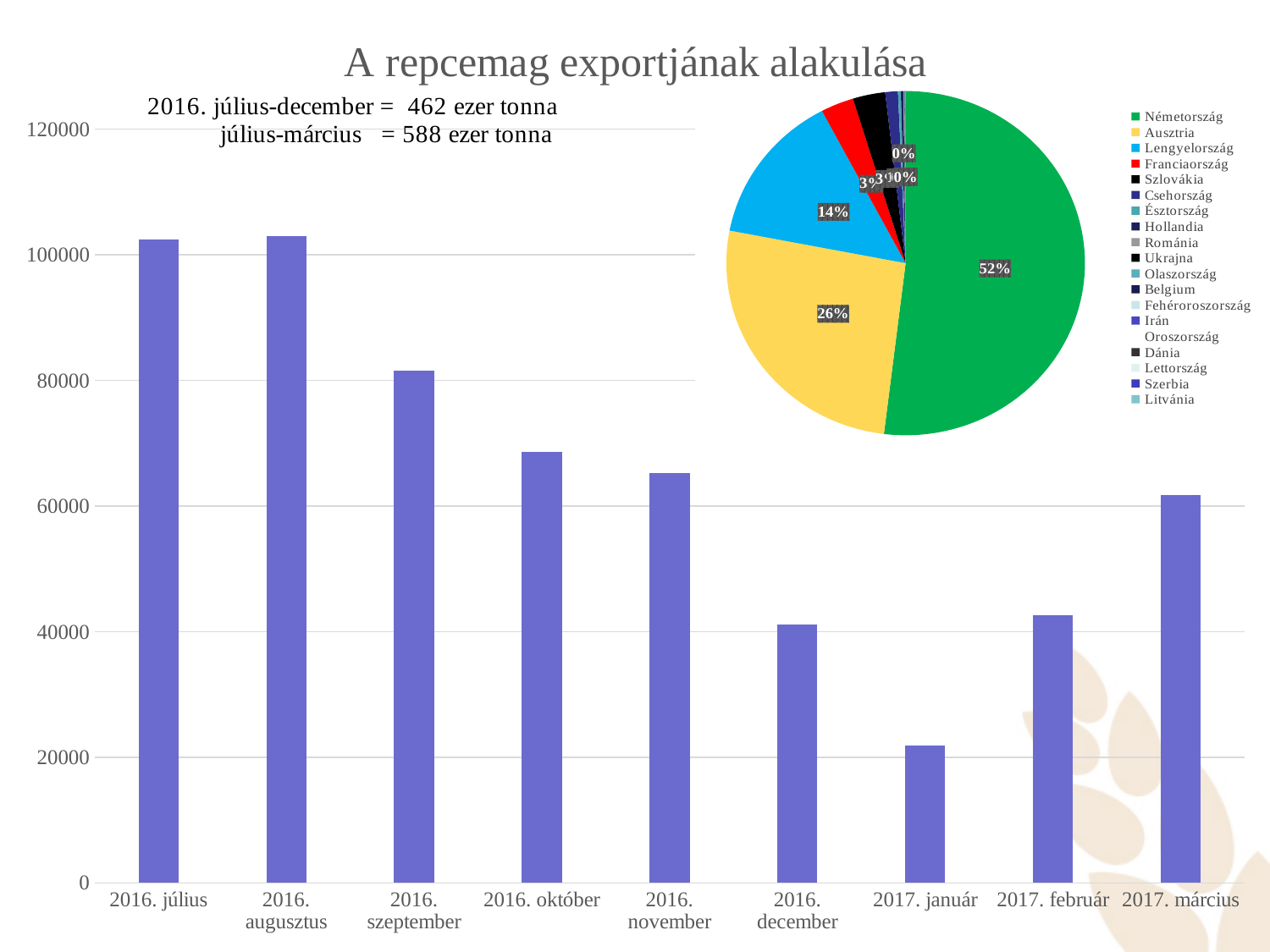
In the bar chart, is the value for 2016. július greater or less than 100000? greater What kind of chart is the large chart on the left showing monthly values? bar chart In the pie chart, what share does Ausztria have? 26% What kind of chart is the chart in the upper right showing country shares? pie chart In the bar chart, do the values rise or fall from 2016. július to 2017. január? fall In the bar chart, which is larger, the value for 2016. szeptember or 2016. október? 2016. szeptember In the bar chart, how many months are shown on the x axis? 9 In the bar chart, is the value for 2017. január greater or less than 40000? less What is the title of the slide's chart? A repcemag exportjának alakulása In the pie chart, what share does Németország have? 52% In the bar chart, is the value for 2016. október greater or less than 80000? less In the bar chart, which month has the lowest value? 2017. január